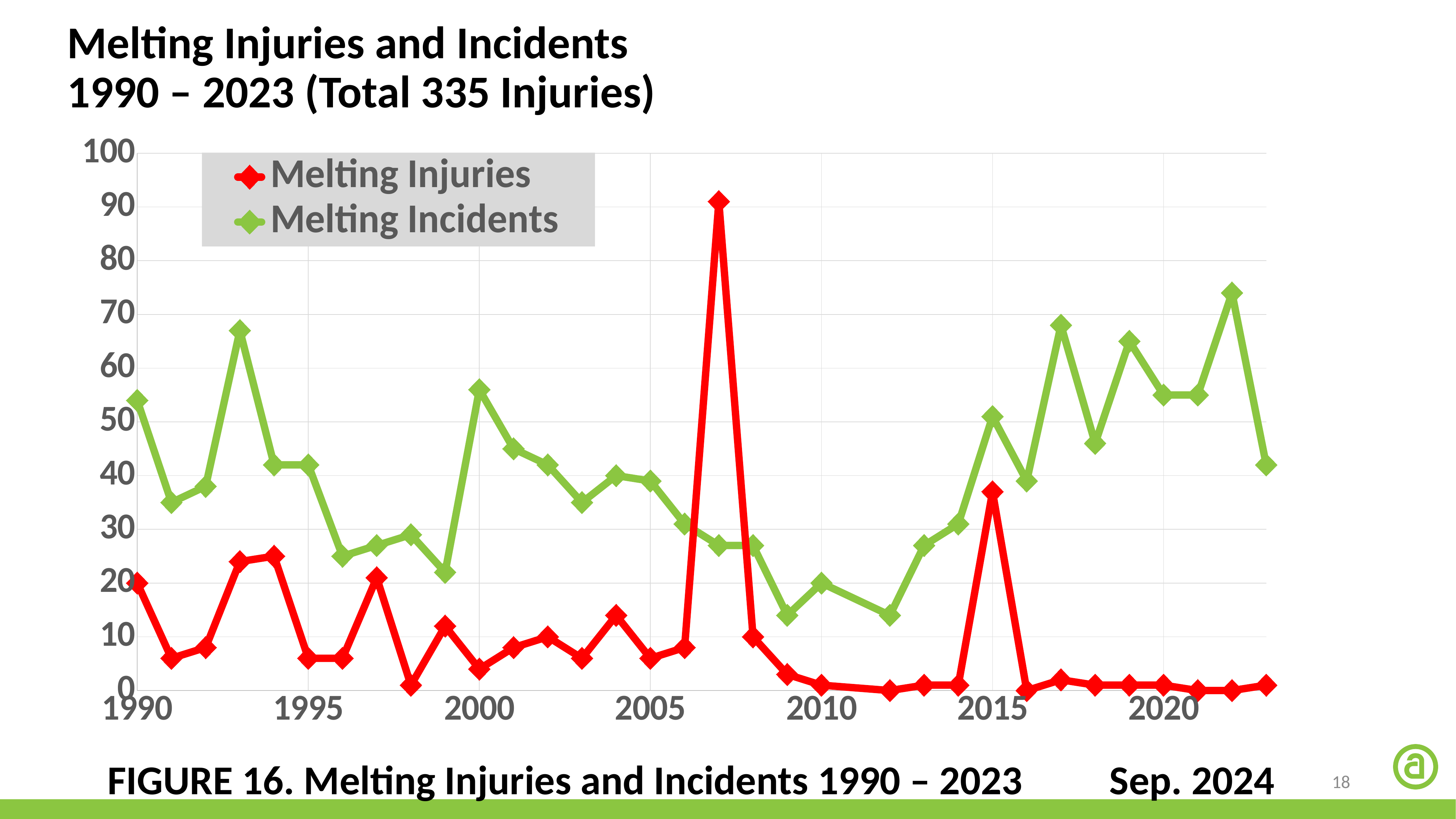
In which year does the Melting Injuries series reach its highest value? 2007 In 2000, which series has the larger value, Melting Injuries or Melting Incidents? Melting Incidents How many series does the legend list? 2 Is the value for Melting Incidents in 1993 greater or less than 60? greater What kind of chart is shown on the slide? line chart Is the value for Melting Incidents in 2010 greater or less than 30? less Is the value for Melting Injuries in 2007 greater or less than 80? greater In which year does the Melting Incidents series reach its highest value? 2022 Which series is drawn in red? Melting Injuries Do the Melting Incidents values rise or fall from 2012 to 2017? rise What is the title of the chart? Melting Injuries and Incidents 1990 – 2023 (Total 335 Injuries)